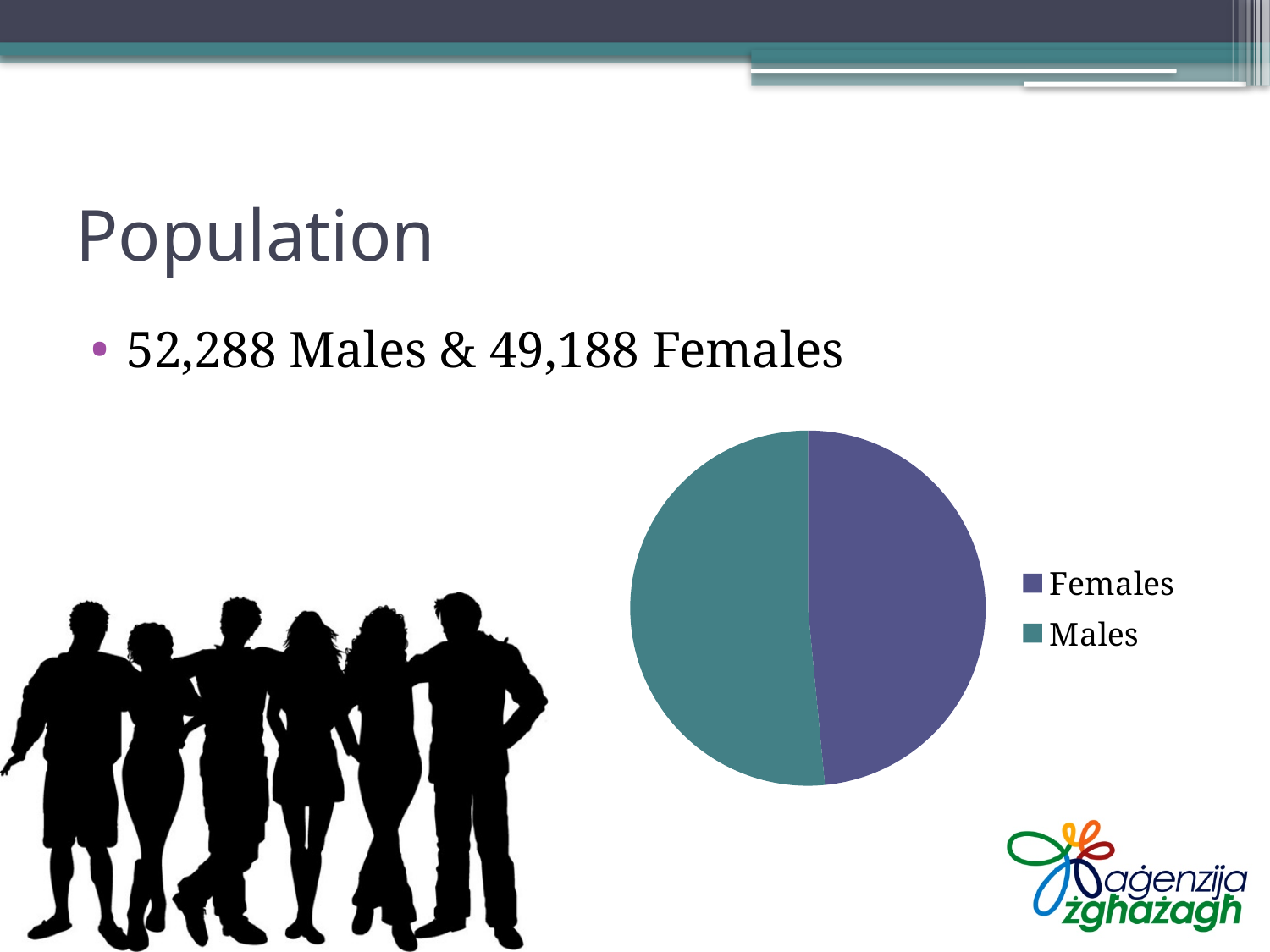
Is the value for Males larger or smaller than the value for Females? larger According to the slide, how many Females are in the population? 49,188 Which slice of the pie chart is larger, Males or Females? Males What is the difference between the number of Males and the number of Females? 3,100 How many slices does the pie chart have? 2 What is the title of the slide containing the pie chart? Population How many entries does the legend of the pie chart list? 2 What kind of chart is shown on the slide? pie chart According to the slide, how many Males are in the population? 52,288 Which colour represents Females in the pie chart? purple What is the total population of Males and Females combined? 101,476